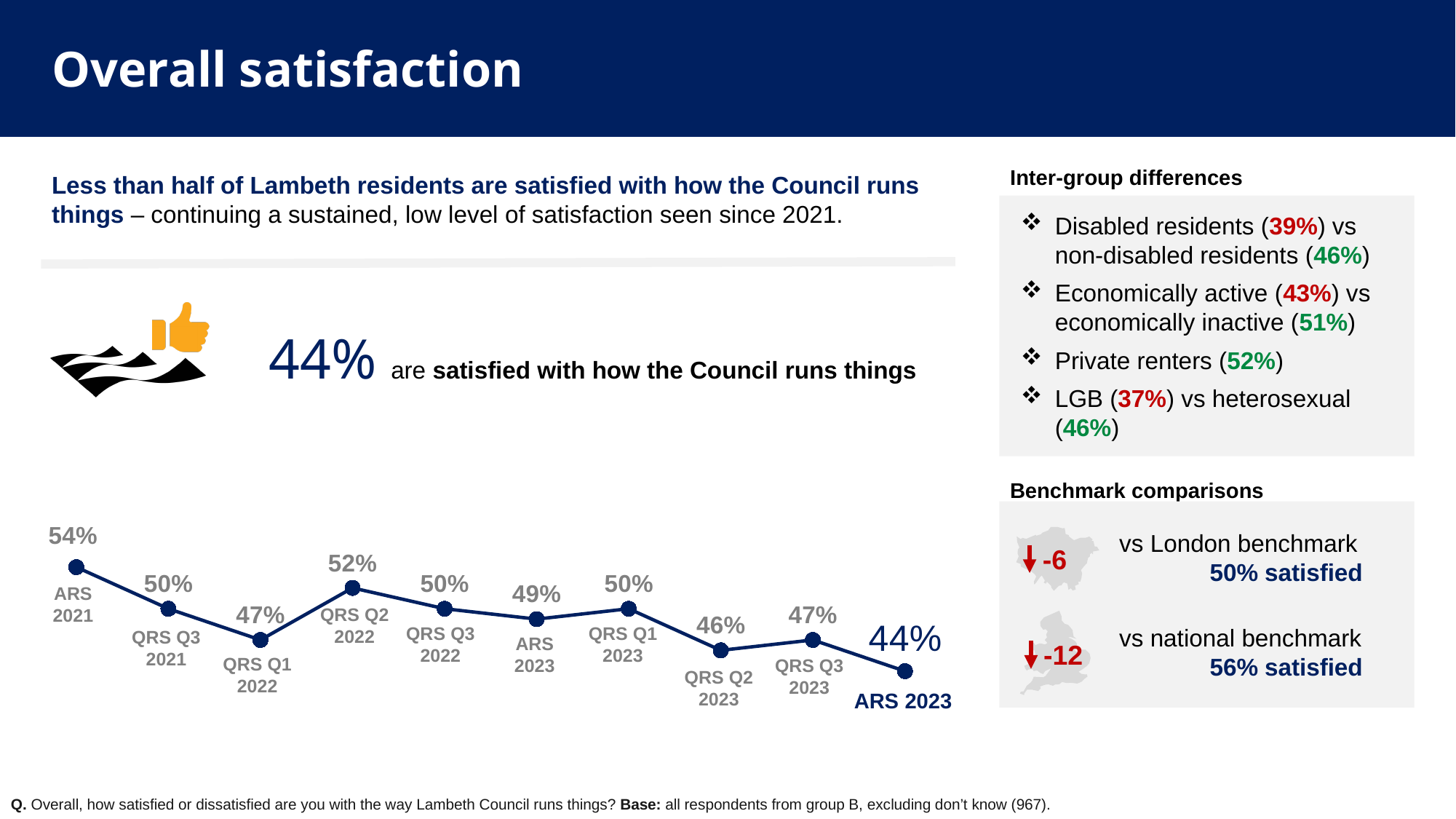
What is the satisfaction value for QRS Q2 2023? 46% What is the satisfaction value for QRS Q1 2022? 47% What is the satisfaction value for ARS 2021? 54% What kind of chart is shown on the slide? Line chart Which point on the line chart has the lowest value? ARS 2023 How many data points are plotted on the line chart? 10 Which point on the line chart has the highest value? ARS 2021 What is the satisfaction value for ARS 2023? 44% Which is larger, the value for QRS Q2 2022 or the value for ARS 2023? QRS Q2 2022 Overall, do the values on the line chart rise or fall from ARS 2021 to ARS 2023? Fall What is the difference between the ARS 2021 value and the ARS 2023 value? 10 percentage points What is the difference between the QRS Q2 2022 value and the QRS Q3 2022 value? 2 percentage points